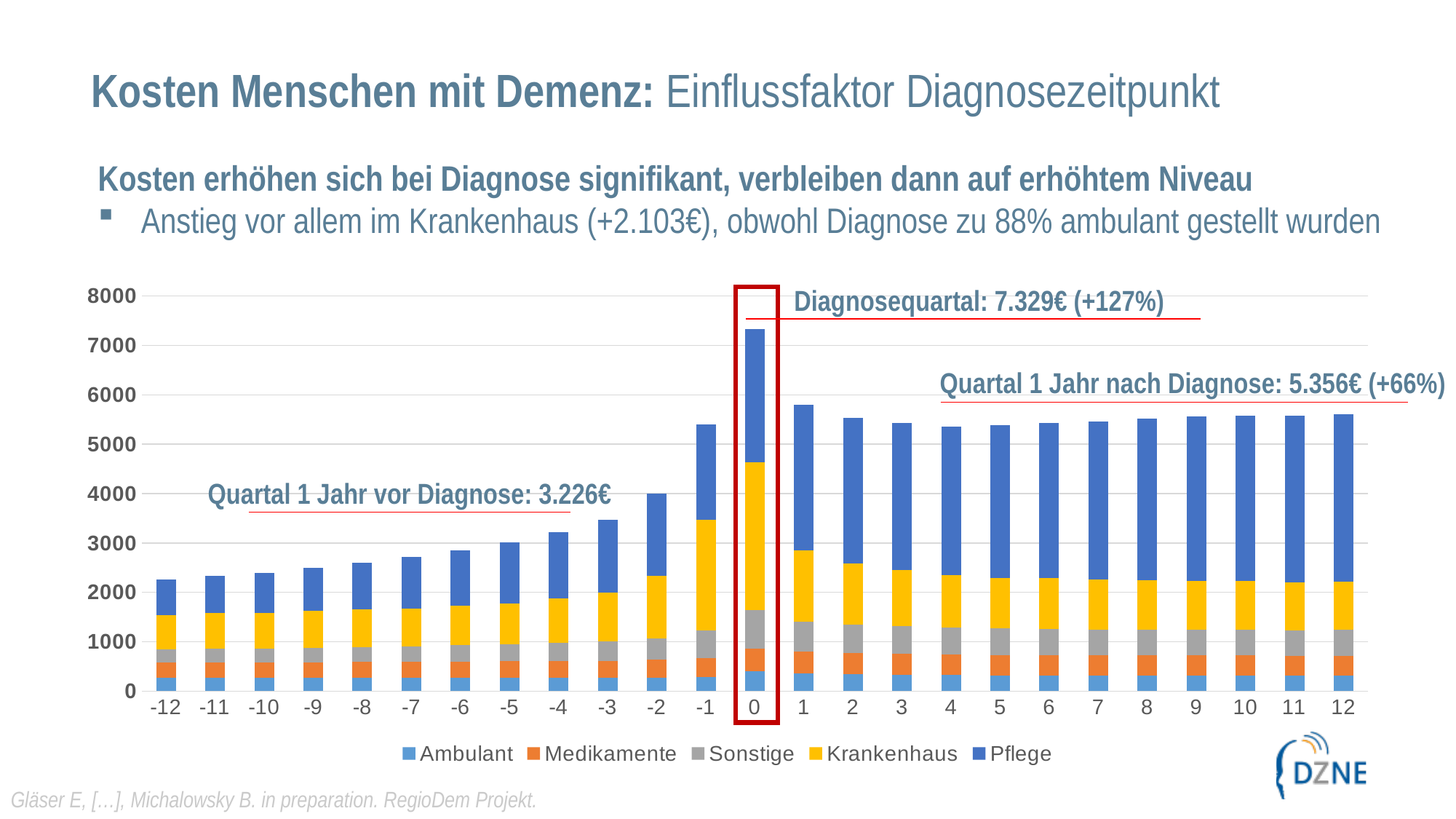
How many quarters (categories) are plotted along the x axis? 25 How many series does the legend list? 5 Do the total costs rise or fall from quarter -12 to quarter -1? Rise What is the difference between the cost in the diagnosis quarter (7.329€) and the quarter one year before diagnosis (3.226€)? 4.103€ According to the annotation, what is the total cost in the diagnosis quarter (Diagnosequartal)? 7.329€ Which has the larger total cost, quarter 1 or quarter -1? Quarter 1 According to the annotation, what is the cost in the quarter one year before diagnosis? 3.226€ According to the annotation, what is the cost in the quarter one year after diagnosis? 5.356€ Which quarter has the lowest total cost? -12 Is the total cost for quarter -12 greater or less than 3000? less What kind of chart is shown on the slide? Stacked bar chart Which quarter has the highest total cost? 0